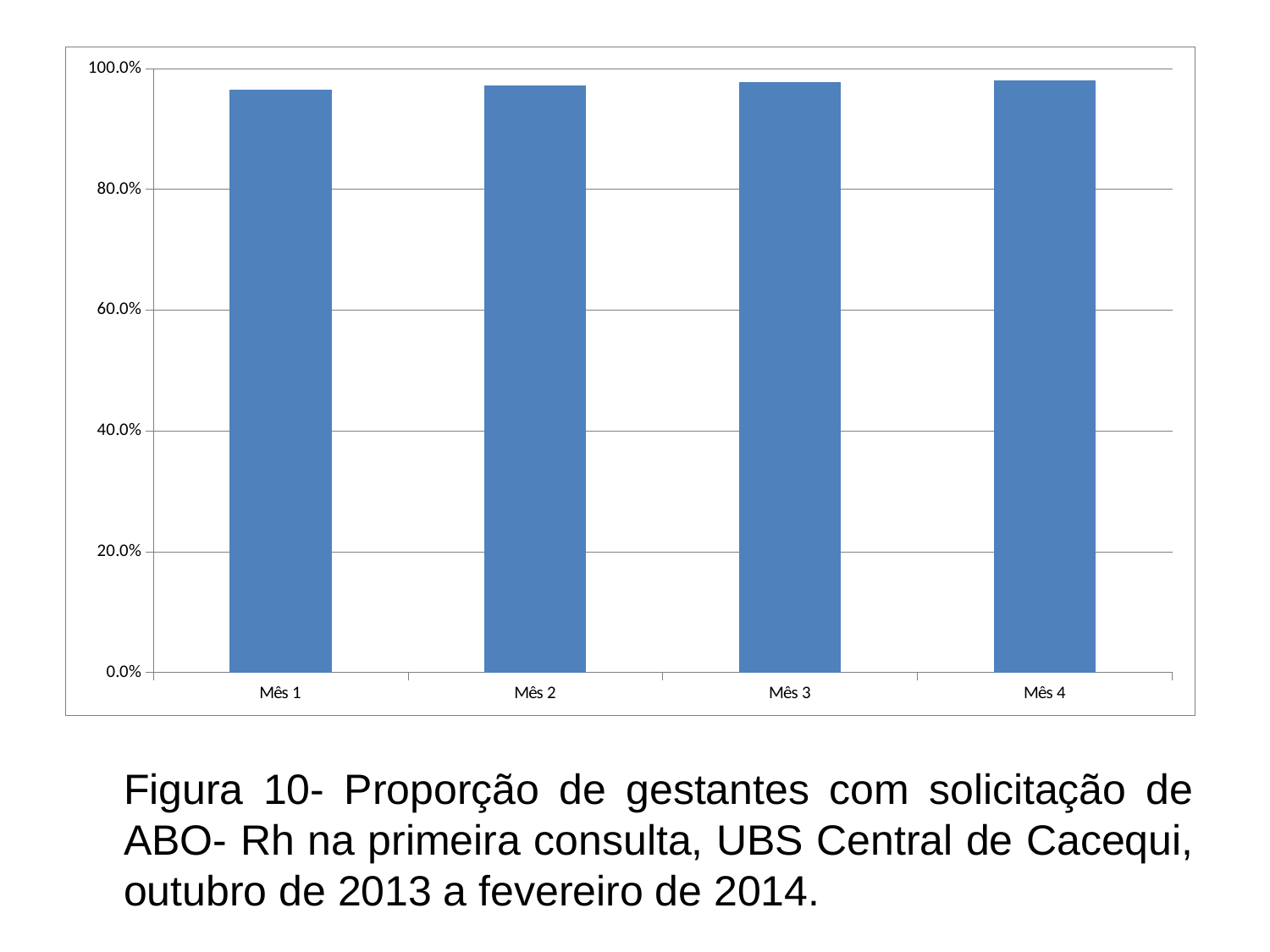
What is the highest value shown on the y axis? 100.0% What is the label of the first category on the x axis? Mês 1 Do the values rise or fall from Mês 1 to Mês 4? rise Is the value for Mês 4 greater or less than 60.0%? greater Which is larger, the value for Mês 1 or the value for Mês 4? Mês 4 Is the value for Mês 3 greater or less than 80.0%? greater Is the value for Mês 1 greater or less than 80.0%? greater How many categories (months) are plotted on the x axis? 4 What kind of chart is shown on the slide? bar chart Which month has the lowest bar? Mês 1